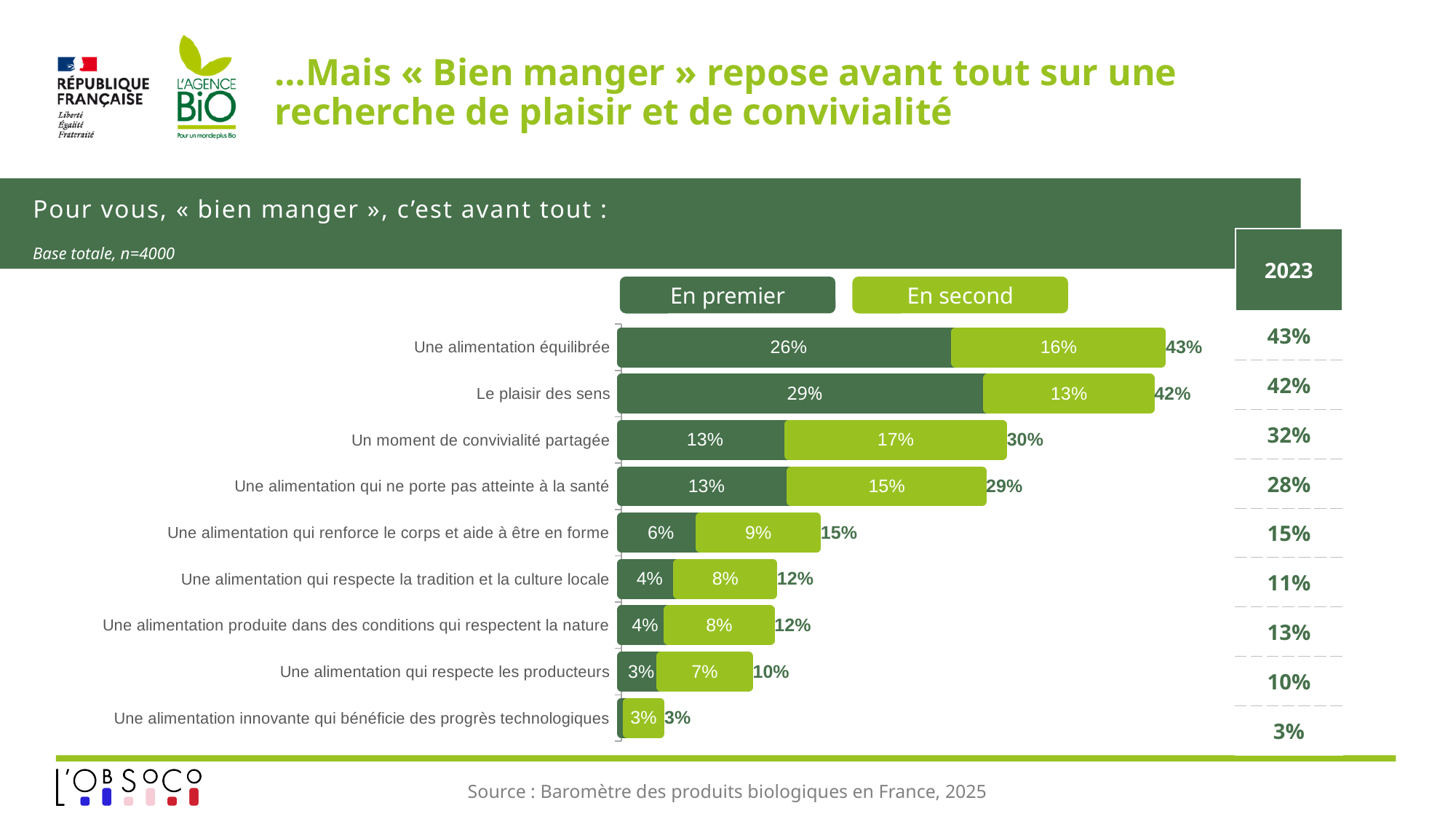
What is the "En second" value for "Un moment de convivialité partagée"? 17% What is the total printed at the end of the bar for "Une alimentation équilibrée"? 43% What are the two legend entries of the chart? En premier, En second What is the 2023 value shown for "Un moment de convivialité partagée"? 32% What is the difference between the "En premier" values for "Une alimentation équilibrée" and "Un moment de convivialité partagée"? 13% What kind of chart is shown on the slide? Stacked bar chart Which category has the lowest total? Une alimentation innovante qui bénéficie des progrès technologiques How many categories are shown in the chart? 9 How many series does the legend list? 2 What is the "En premier" value for "Le plaisir des sens"? 29% Which is larger: the "En second" value for "Une alimentation équilibrée" or for "Le plaisir des sens"? Une alimentation équilibrée Which category has the highest "En premier" value? Le plaisir des sens